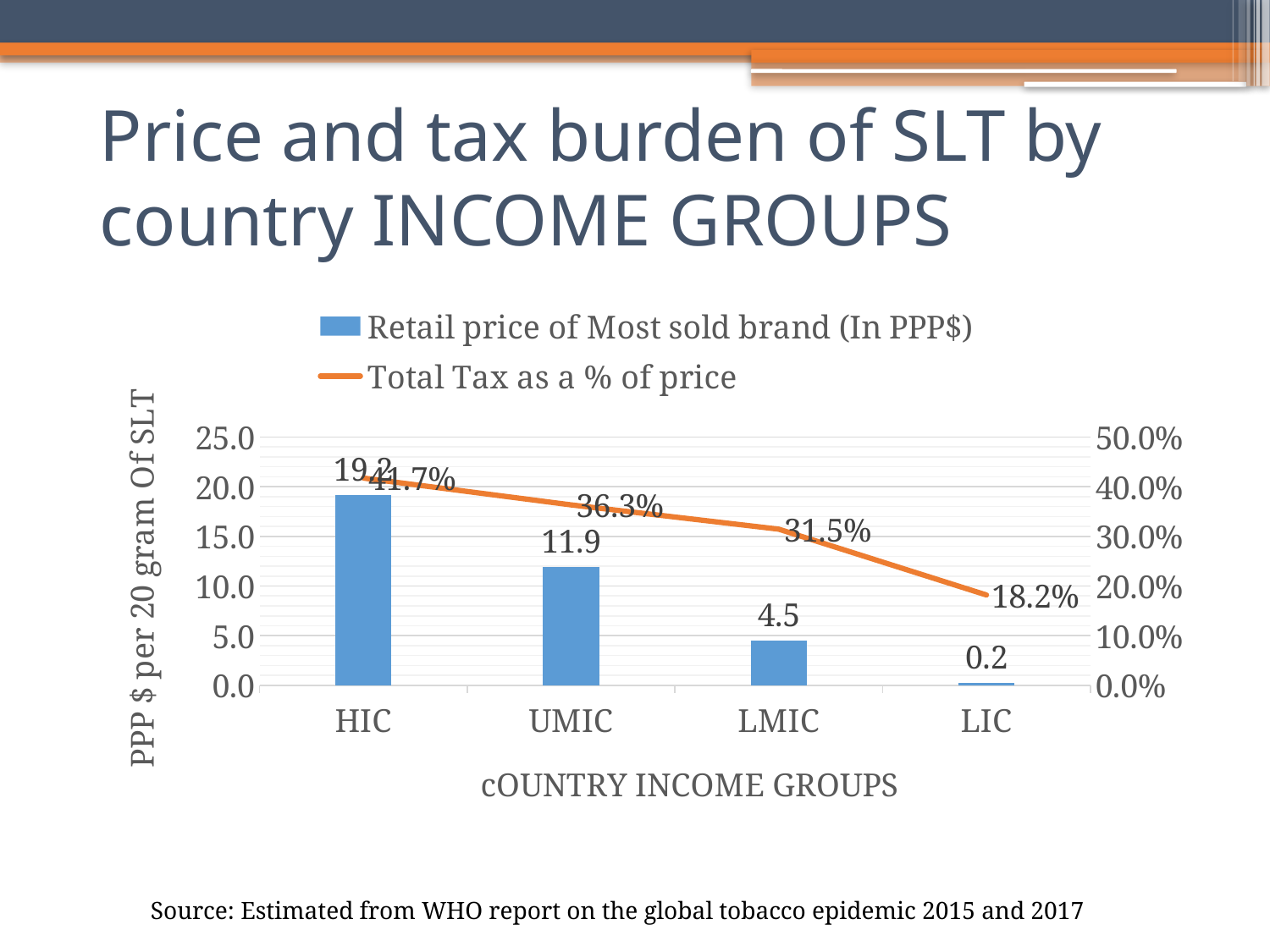
What is the difference in retail price of the most sold brand between UMIC and LMIC? 7.4 Which has a higher total tax as a % of price, UMIC or LMIC? UMIC How many series does the legend list? 2 What is the retail price of the most sold brand for LIC? 0.2 What is the retail price of the most sold brand for LMIC? 4.5 Which country income group has the lowest total tax as a % of price? LIC Which country income group has the highest retail price of the most sold brand? HIC What is the total tax as a % of price for UMIC? 36.3% What is the retail price of the most sold brand for UMIC? 11.9 What is the total tax as a % of price for LIC? 18.2% How many country income groups are shown on the x axis? 4 Does the total tax as a % of price rise or fall from HIC to LIC along the x axis? fall